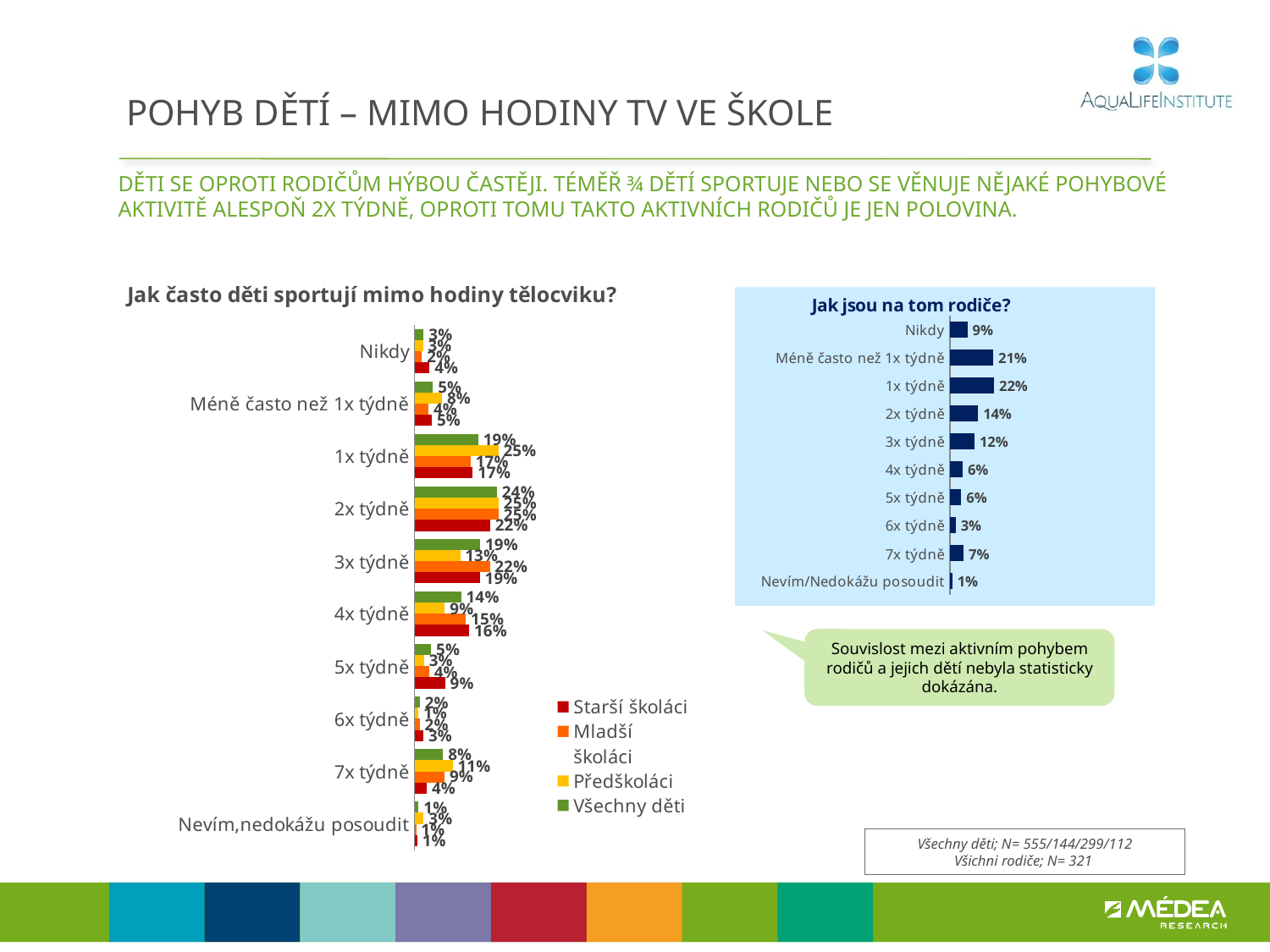
In the chart 'Jak jsou na tom rodiče?', which category has the lowest value? Nevím/Nedokážu posoudit In the chart 'Jak jsou na tom rodiče?', what is the difference between '2x týdně' and '3x týdně'? 2% What type of chart is 'Jak často děti sportují mimo hodiny tělocviku?'? Bar chart In the chart 'Jak často děti sportují mimo hodiny tělocviku?', what is the value for 'Starší školáci' at '4x týdně'? 16% In the chart 'Jak jsou na tom rodiče?', what is the value for 'Nikdy'? 9% In the chart 'Jak jsou na tom rodiče?', which is larger: '7x týdně' or '6x týdně'? 7x týdně In the chart 'Jak často děti sportují mimo hodiny tělocviku?', what is the value for 'Všechny děti' at '2x týdně'? 24% How many series does the legend of the chart 'Jak často děti sportují mimo hodiny tělocviku?' list? 4 How many categories are shown in the chart 'Jak jsou na tom rodiče?'? 10 In the chart 'Jak jsou na tom rodiče?', what is the value for '1x týdně'? 22% In the chart 'Jak jsou na tom rodiče?', which category has the highest value? 1x týdně In the chart 'Jak často děti sportují mimo hodiny tělocviku?', which series is shown in green? Všechny děti